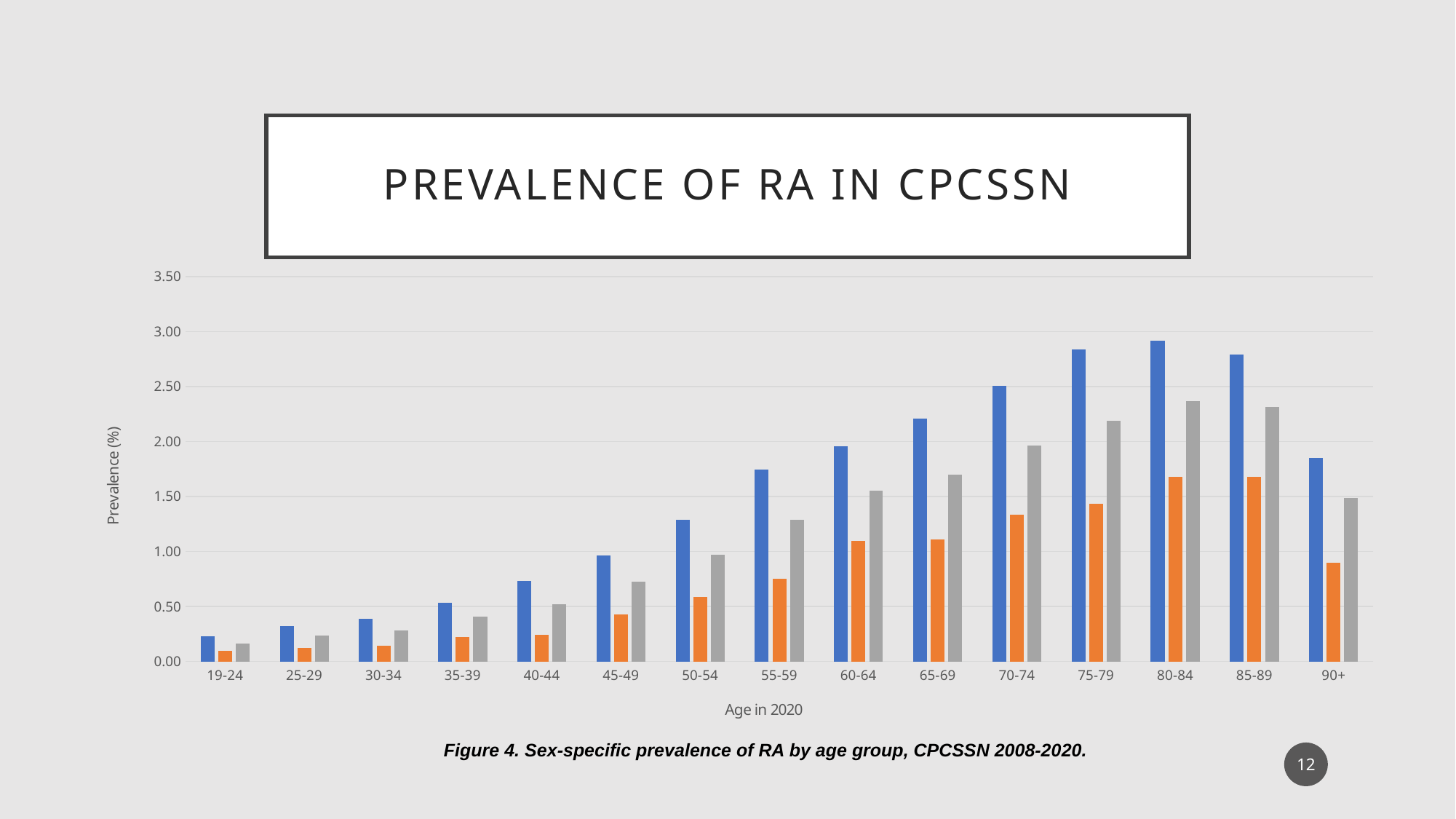
Is the orange bar for the 90+ age group greater or less than 1.00? less Is the gray bar for the 80-84 age group greater or less than 2.00? greater Do the blue bars rise or fall from the 19-24 age group to the 75-79 age group? Rise How many age groups are shown on the x axis of the chart? 15 Is the blue bar for the 55-59 age group greater or less than 1.50? greater Which age group has the lowest blue bar in the chart? 19-24 What is the label on the y axis of the chart? Prevalence (%) In the 70-74 age group, which bar is taller, the blue bar or the orange bar? The blue bar How many bars are plotted for each age group in the chart? 3 Which age group has the highest blue bar in the chart? 80-84 What kind of chart is shown on the slide? Bar chart